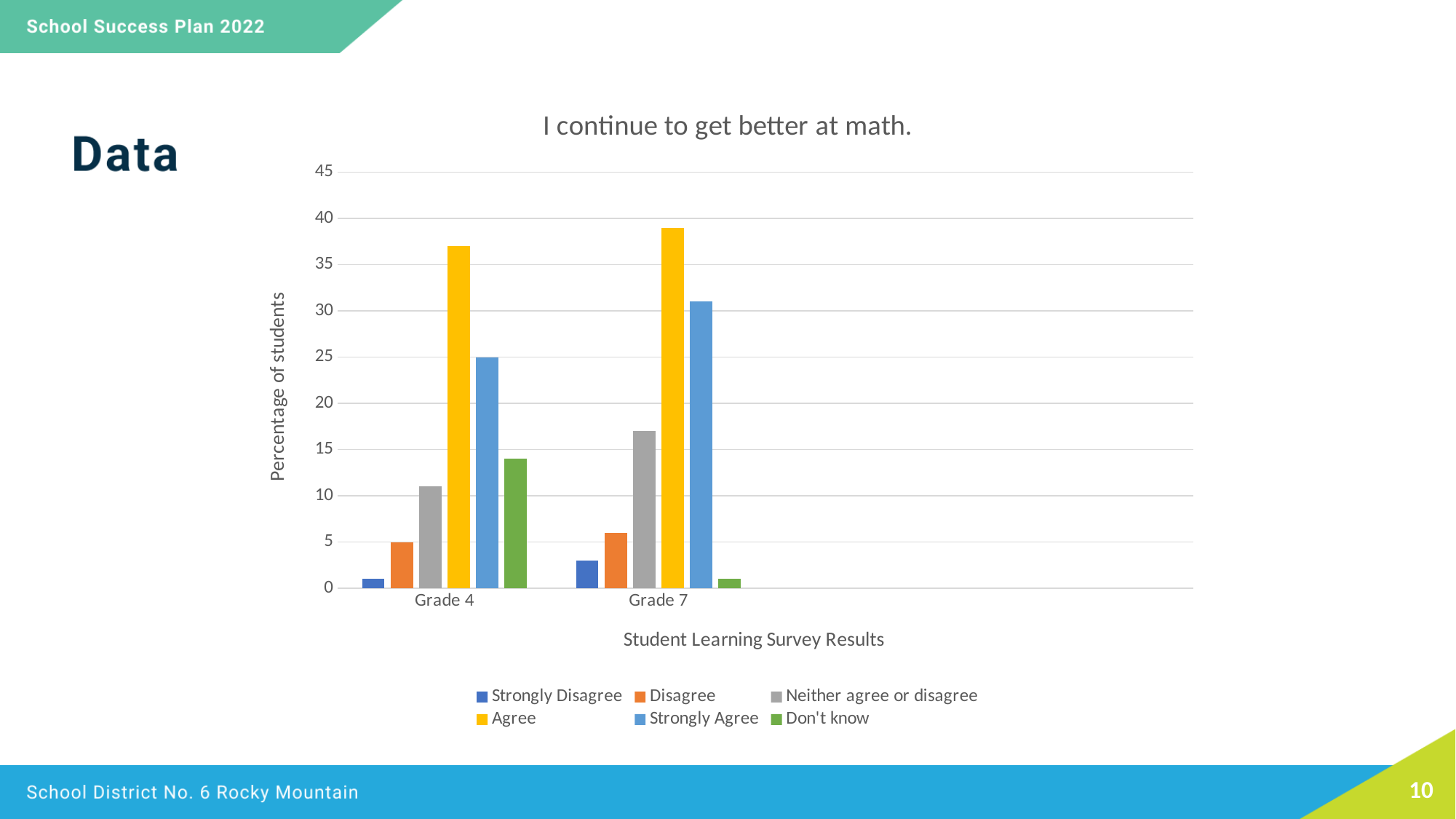
Which response has the highest value for Grade 7? Agree What is the title of the chart? I continue to get better at math. Which is larger, Strongly Agree for Grade 4 or Strongly Agree for Grade 7? Grade 7 Which is larger, Don't know for Grade 4 or Don't know for Grade 7? Grade 4 What kind of chart is shown on the slide? bar chart How many series does the legend list? 6 How many grade categories are shown on the x axis? 2 Which response has the lowest value for Grade 4? Strongly Disagree Is the value for Neither agree or disagree in Grade 7 greater or less than 15? greater What is the value for Strongly Agree in Grade 4? 25 Is the value for Agree in Grade 4 greater or less than 35? greater What is the value for Disagree in Grade 4? 5